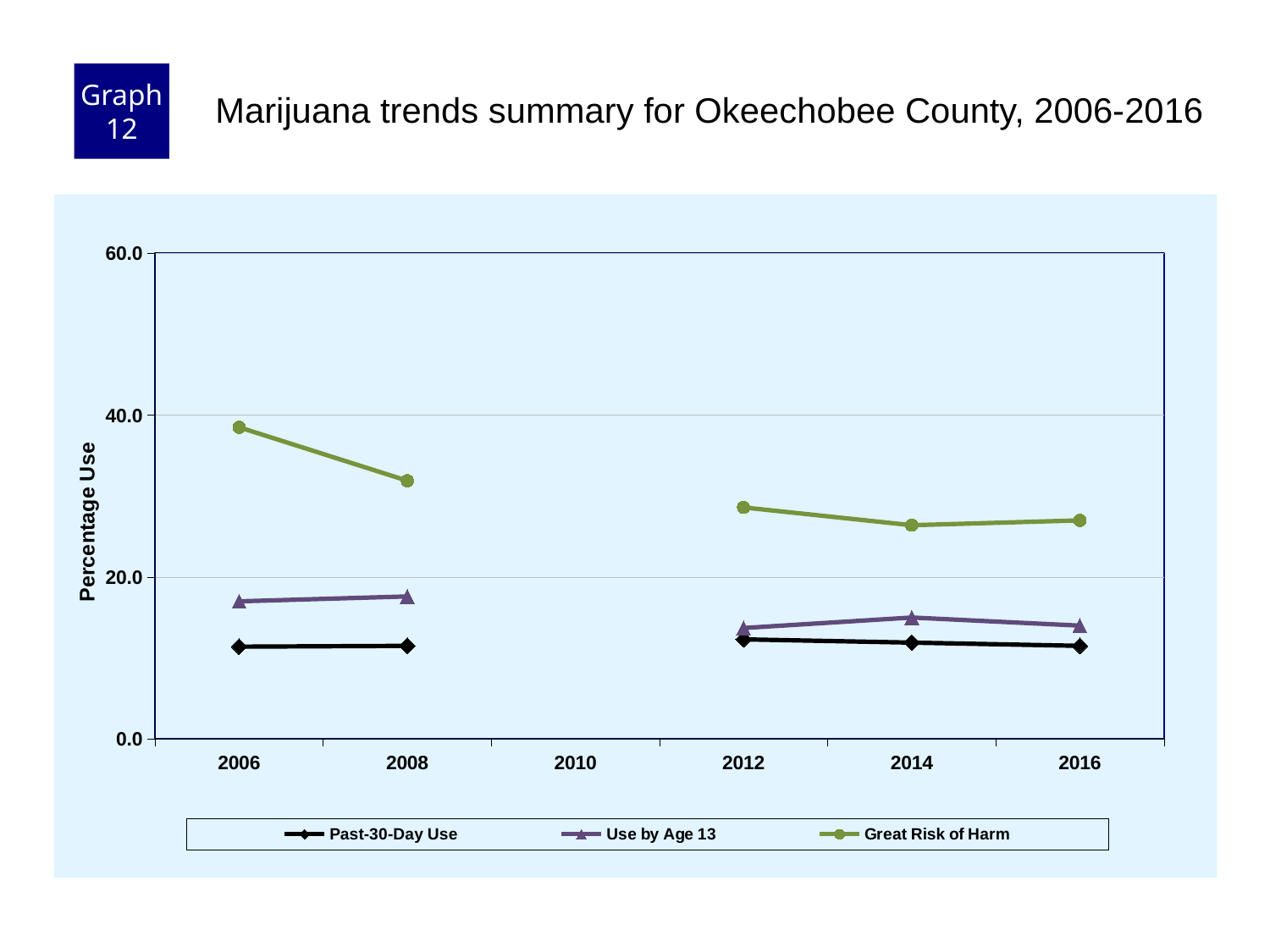
What is the label on the y axis? Percentage Use Which series is listed first in the legend? Past-30-Day Use Is the value for Past-30-Day Use in 2006 greater or less than 20.0? less Is the value for Great Risk of Harm in 2008 greater or less than 20.0? greater Does the Great Risk of Harm series rise or fall from 2006 to 2008? fall How many series does the legend list? 3 How many years are labelled on the x axis? 6 In which year is the Great Risk of Harm series at its highest? 2006 What kind of chart is shown on the slide? line chart In 2012, which is larger: Great Risk of Harm or Past-30-Day Use? Great Risk of Harm Is the value for Great Risk of Harm in 2006 greater or less than 40.0? less